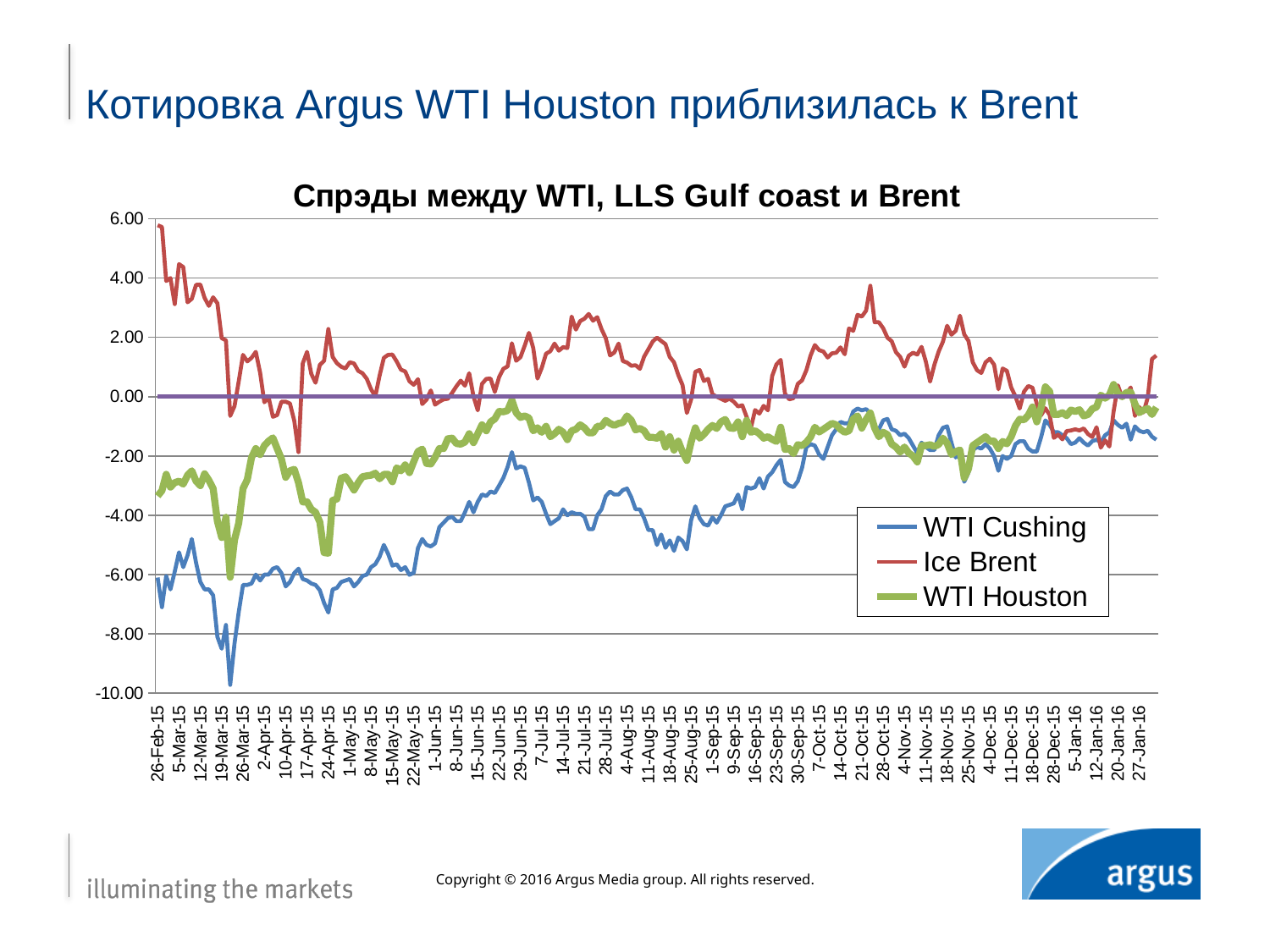
Is the peak value of Ice Brent around 21-Oct-15 greater or less than 2.00? greater How many series does the chart legend list? 3 Does the Ice Brent series rise or fall overall from 26-Feb-15 to 27-Jan-16? fall What is the title of the chart? Спрэды между WTI, LLS Gulf coast и Brent What kind of chart is shown on the slide? line chart Around 21-Oct-15, which series is higher, Ice Brent or WTI Houston? Ice Brent Is the value for WTI Houston at 26-Feb-15 greater or less than -2.00? less What colour is the WTI Houston line in the chart? green At 26-Feb-15, which series has the higher value, Ice Brent or WTI Cushing? Ice Brent Does the WTI Cushing series rise or fall overall from 26-Feb-15 to 27-Jan-16? rise Is the lowest value reached by WTI Cushing greater or less than -8.00? less